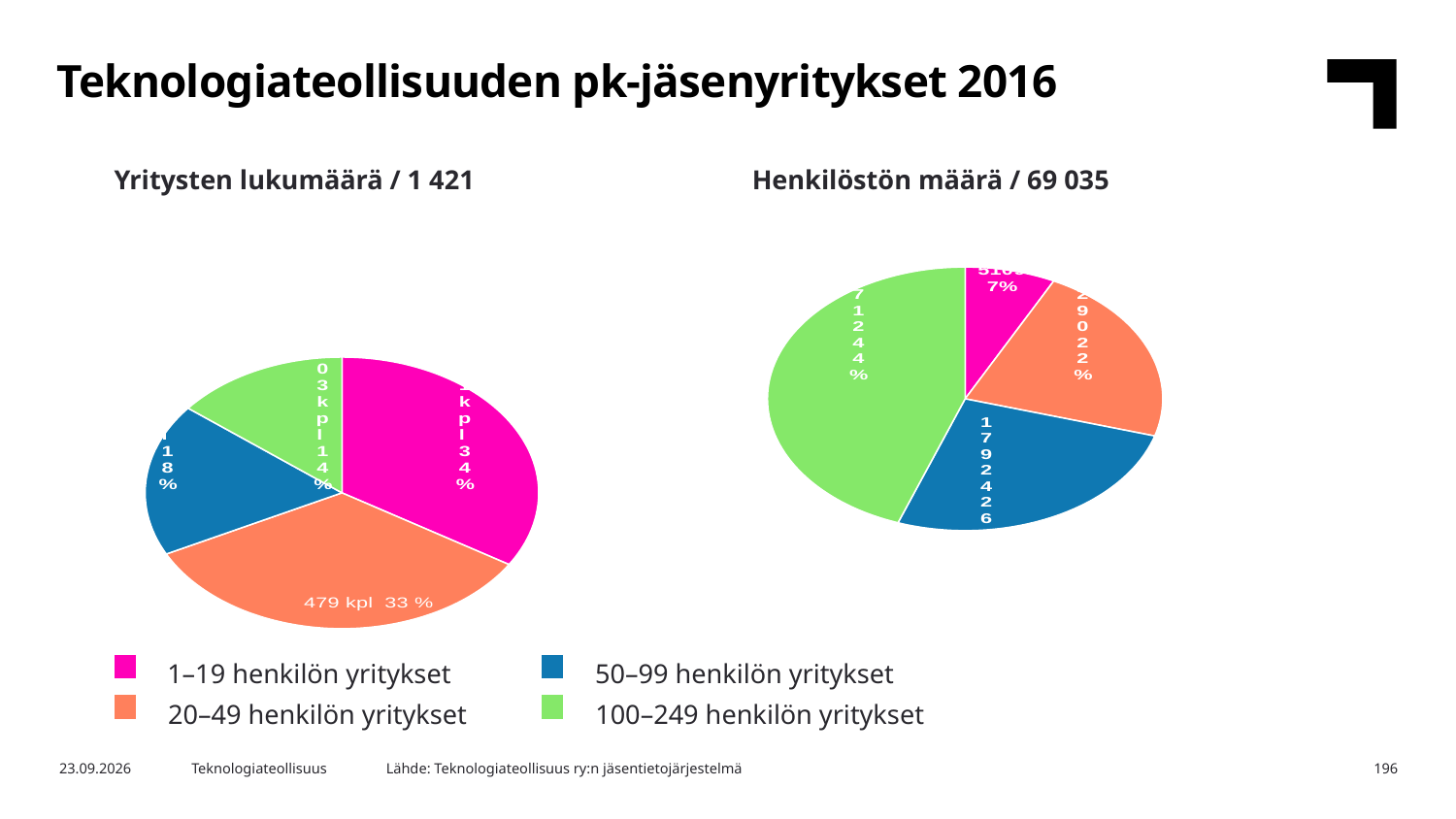
In the 'Yritysten lukumäärä / 1 421' chart, what share of the pie is 100–249 henkilön yritykset? 14 % What kind of chart is used for 'Yritysten lukumäärä / 1 421'? Pie chart In the 'Yritysten lukumäärä / 1 421' chart, what is the difference in percentage share between 50–99 henkilön yritykset and 100–249 henkilön yritykset? 4 % In the 'Yritysten lukumäärä / 1 421' chart, which category has the smallest slice? 100–249 henkilön yritykset In the 'Henkilöstön määrä / 69 035' chart, what share of the pie is 1–19 henkilön yritykset? 7% In the 'Yritysten lukumäärä / 1 421' chart, what is the number of companies (kpl) for 20–49 henkilön yritykset? 479 kpl In the 'Yritysten lukumäärä / 1 421' chart, what share of the pie is 20–49 henkilön yritykset? 33 % How many categories does the legend list? 4 Which colour represents 20–49 henkilön yritykset in the charts? Orange In the 'Henkilöstön määrä / 69 035' chart, which category has the largest slice? 100–249 henkilön yritykset In the 'Yritysten lukumäärä / 1 421' chart, how many slices does the pie have? 4